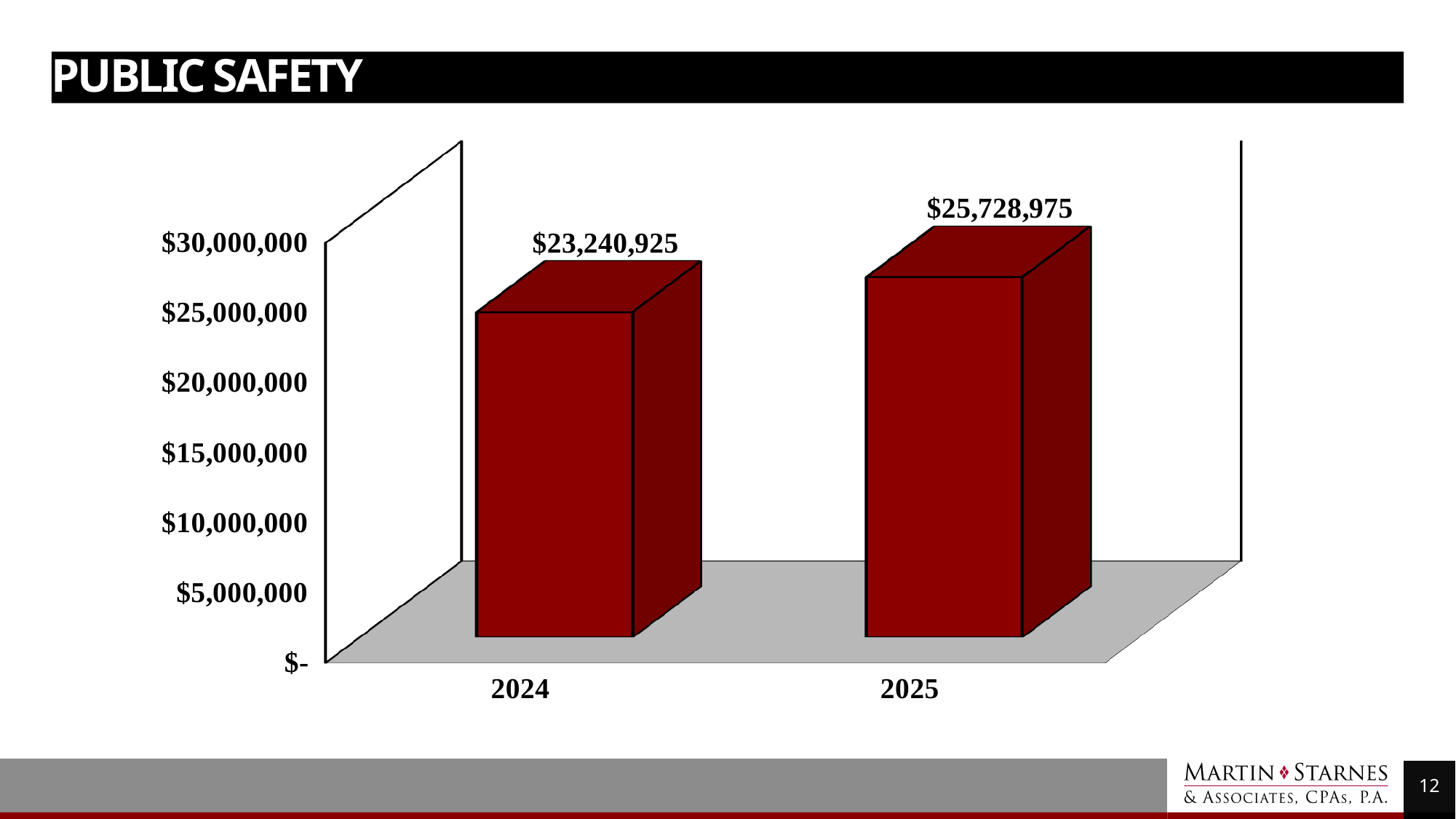
What kind of chart is shown on the slide? bar chart What is the value for 2024? $23,240,925 Which is larger, the value for 2024 or the value for 2025? 2025 What is the value for 2025? $25,728,975 Is the value for 2024 greater or less than $20,000,000? greater Is the value for 2025 greater or less than $30,000,000? less Which year has the highest value? 2025 Which year has the lowest value? 2024 How many years are shown on the chart? 2 Do the values rise or fall from 2024 to 2025? rise What is the difference between the 2025 and 2024 values? $2,488,050 What is the title of the slide? PUBLIC SAFETY